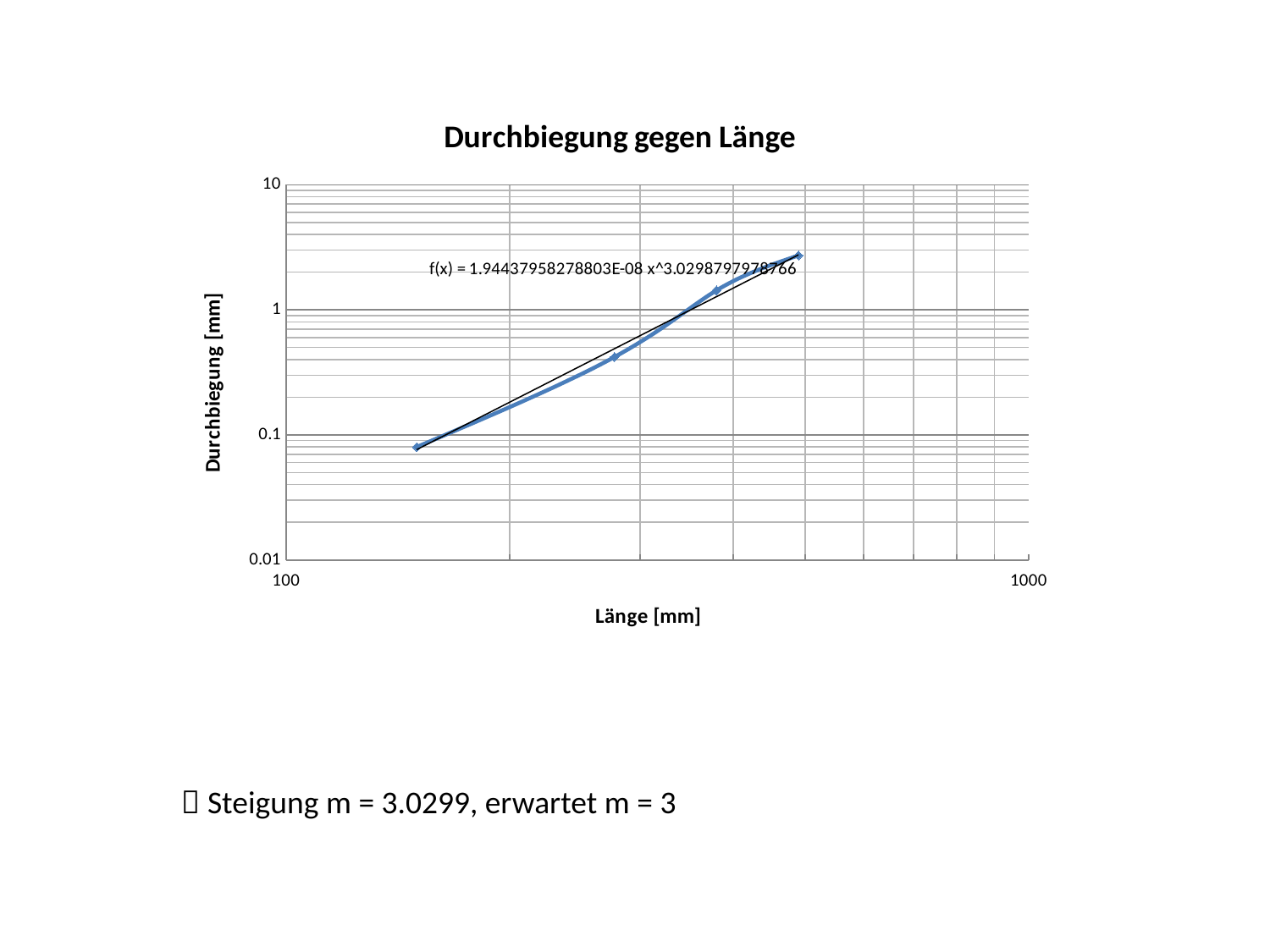
Is the Durchbiegung value of the second data point from the left greater or less than 1? less What is the label of the x axis? Länge [mm] What kind of chart is shown on the slide? Line chart What is the lowest value shown on the x axis? 100 Which data point has the highest Durchbiegung value, the leftmost or the rightmost? Rightmost What is the highest value shown on the y axis? 10 What exponent of x is given in the trendline equation printed on the chart? 3.0298797978766 Is the Durchbiegung value of the leftmost data point greater or less than 1? less What is the title of the chart? Durchbiegung gegen Länge Is the Durchbiegung value of the rightmost data point greater or less than 1? greater Do the plotted values rise or fall as Länge increases? Rise How many data points are plotted on the chart? 4